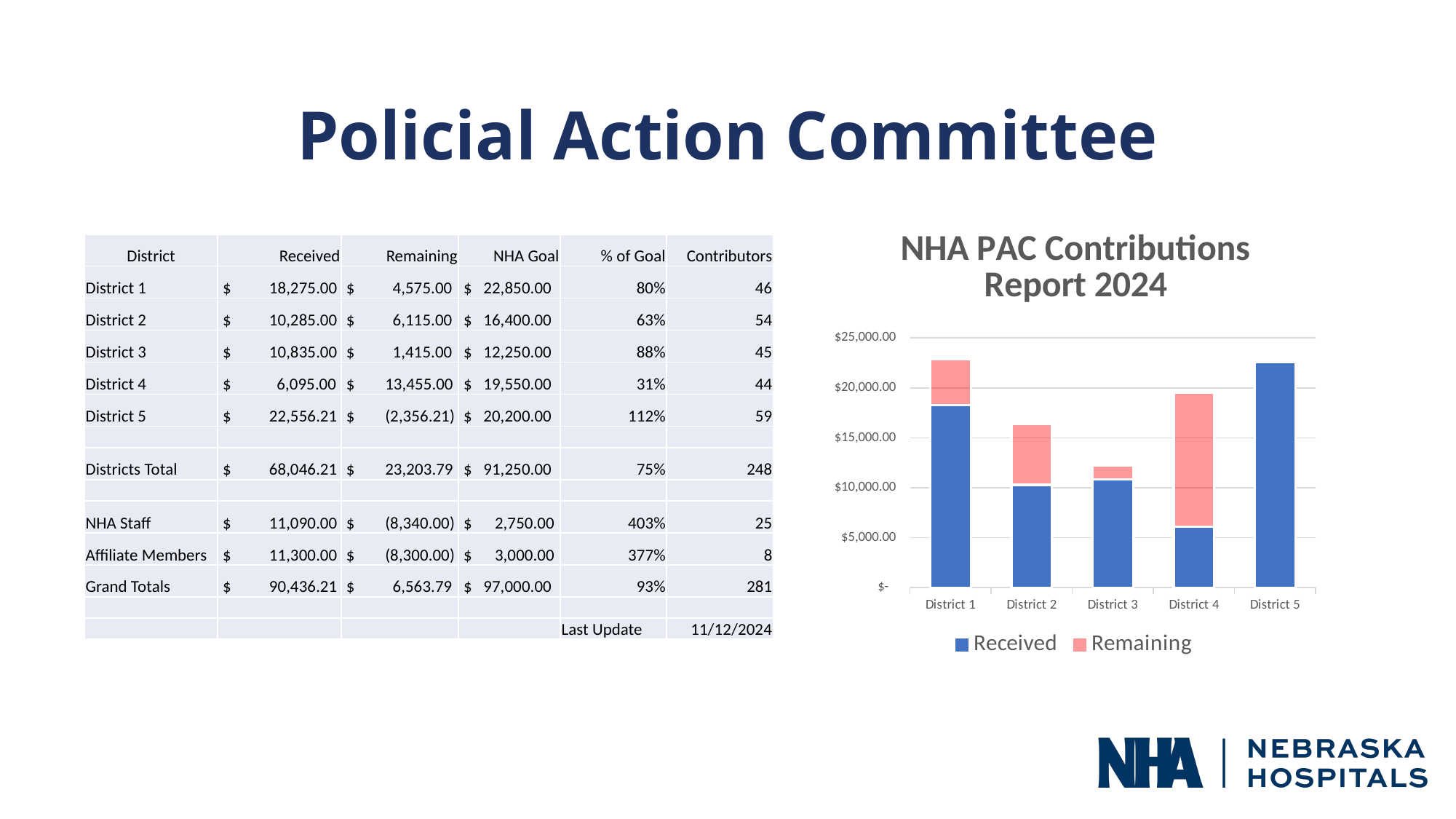
In the NHA PAC Contributions Report 2024 chart, is the Received value for District 4 greater or less than $10,000.00? less Which has the larger Received value in the NHA PAC Contributions Report 2024 chart, District 1 or District 2? District 1 In the NHA PAC Contributions Report 2024 chart, is the Received value for District 1 greater or less than $15,000.00? greater Which district has the lowest Received value in the NHA PAC Contributions Report 2024 chart? District 4 Which district has the largest Remaining segment in the NHA PAC Contributions Report 2024 chart? District 4 How many districts are shown on the x axis of the NHA PAC Contributions Report 2024 chart? 5 Which district has the highest Received value in the NHA PAC Contributions Report 2024 chart? District 5 What is the total height of the stacked bar for District 2 (Received plus Remaining) in the NHA PAC Contributions Report 2024 chart? $16,400.00 How many series does the legend of the NHA PAC Contributions Report 2024 chart list? 2 What is the title of the chart on the slide? NHA PAC Contributions Report 2024 What is the Received amount for District 3 shown on the slide? $10,835.00 What kind of chart is the NHA PAC Contributions Report 2024? bar chart